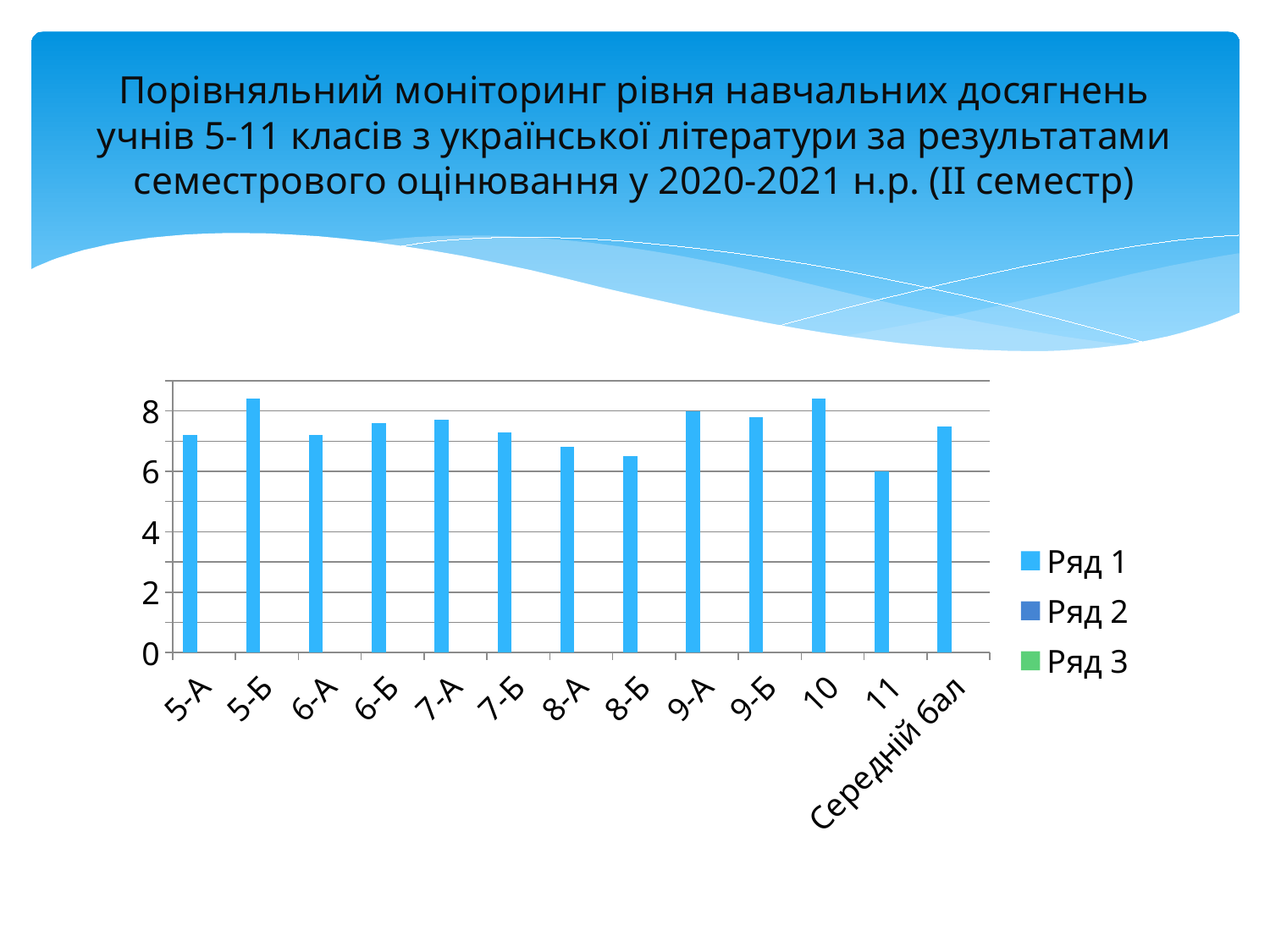
What kind of chart is shown on the slide? bar chart Is the value for 8-А greater or less than 8? less Which category has the lowest bar in the chart? 11 Is the value for 8-Б greater or less than 8? less How many series does the chart's legend list? 3 How many categories are shown on the x axis of the chart? 13 Is the value for 5-Б greater or less than 8? greater Which has the larger value, 5-Б or 8-Б? 5-Б What is the label of the last category on the x axis? Середній бал Which has the larger value, 11 or 9-А? 9-А What are the three entries listed in the chart's legend? Ряд 1, Ряд 2, Ряд 3